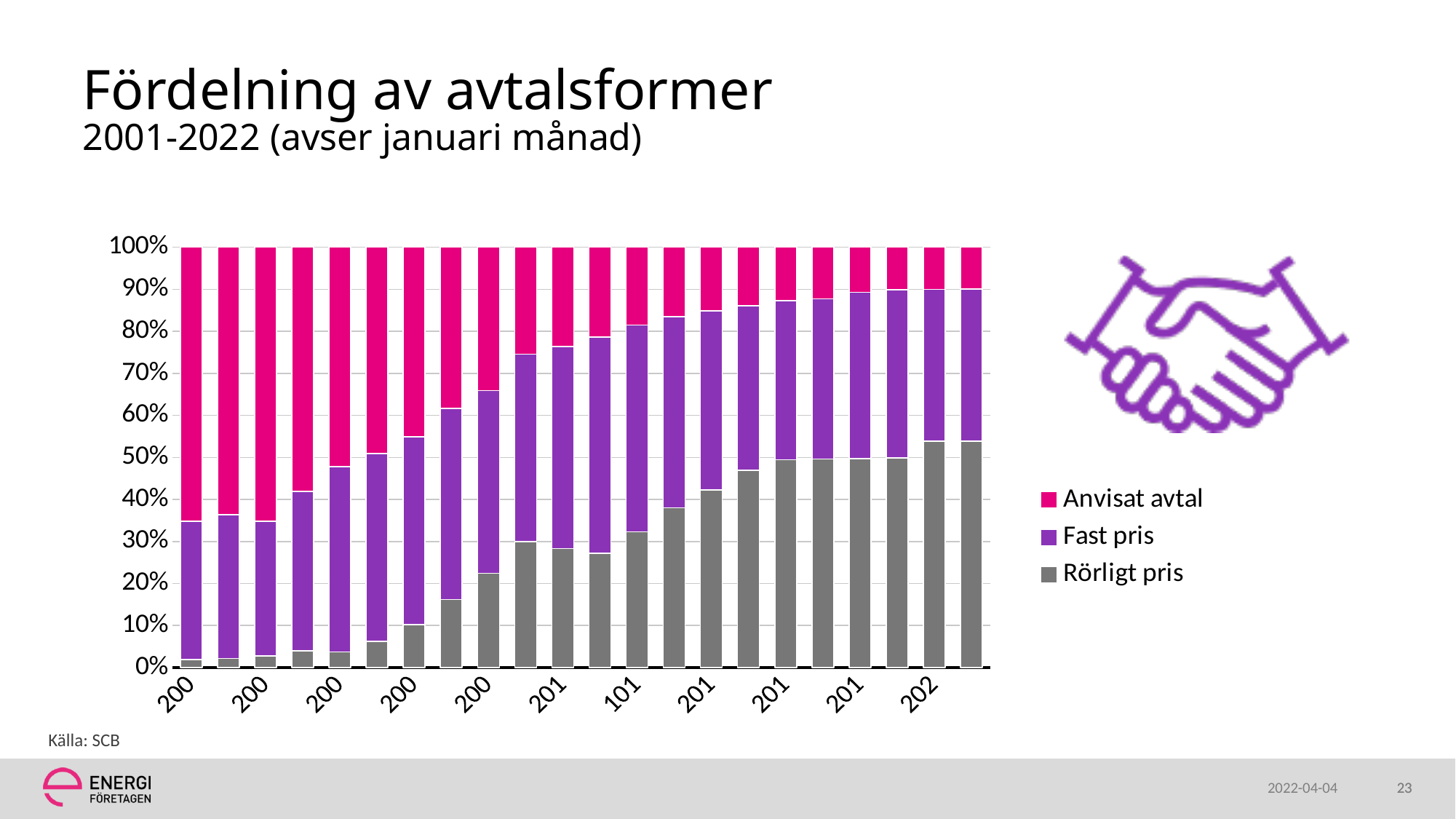
How many bars are plotted in the chart? 22 Which series is shown in grey in the chart? Rörligt pris Does the share of Anvisat avtal rise or fall from the leftmost bar to the rightmost bar? Fall What kind of chart is shown on the slide? Stacked bar chart Is the Rörligt pris share in the leftmost bar greater or less than 10%? less How many series does the legend list? 3 Is the Anvisat avtal share in the leftmost bar greater or less than 60%? greater Does the share of Rörligt pris rise or fall from the leftmost bar to the rightmost bar? Rise Which series has the largest share in the leftmost bar? Anvisat avtal Which series has the largest share in the rightmost bar? Rörligt pris What is the title of the chart on the slide? Fördelning av avtalsformer Is the Rörligt pris share in the rightmost bar greater or less than 50%? greater